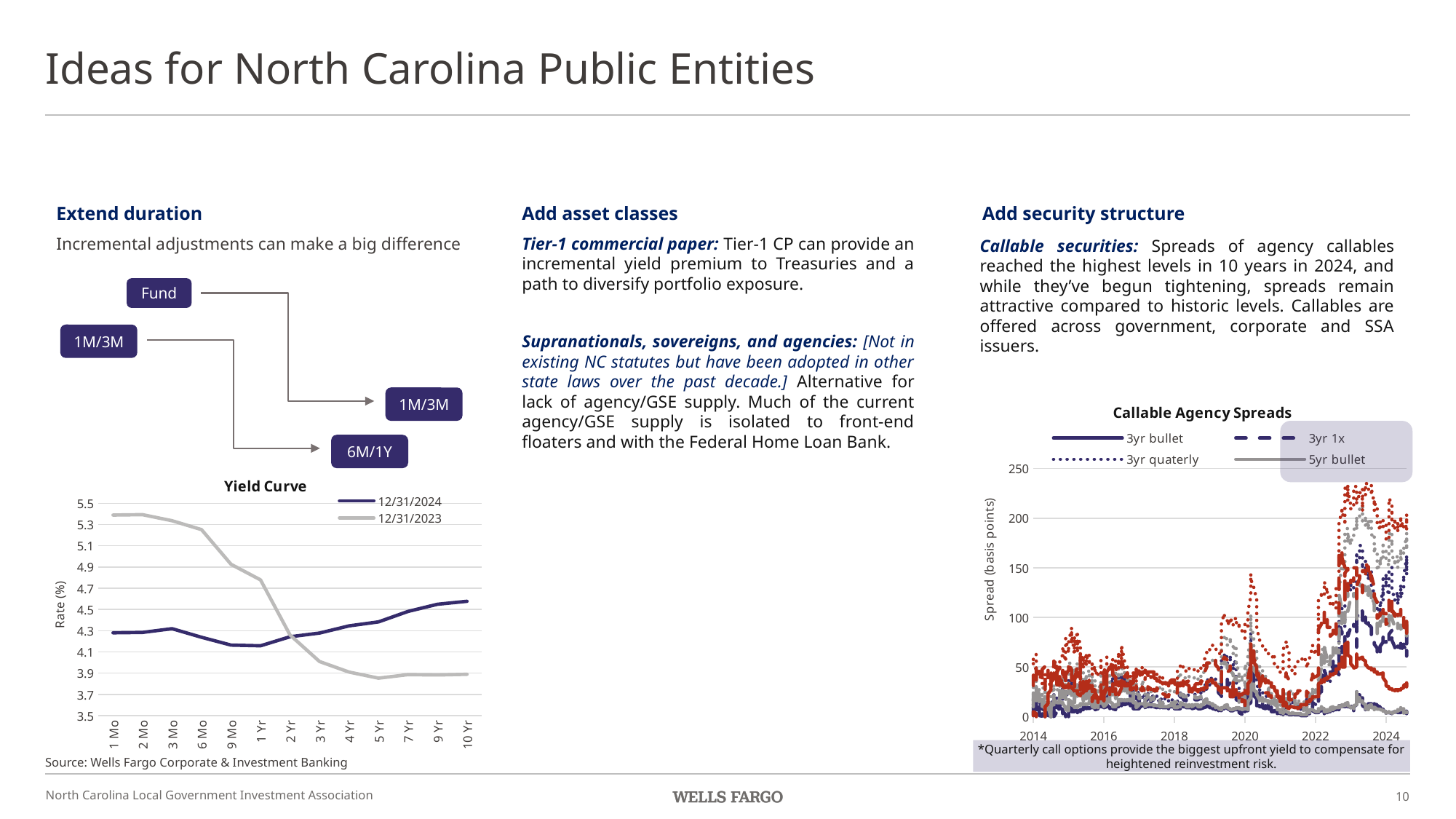
How many series does the legend of the Yield Curve chart list? 2 In the Yield Curve chart, which series has the higher rate at 10 Yr, 12/31/2024 or 12/31/2023? 12/31/2024 In the Callable Agency Spreads chart, is the peak value of the 3yr quaterly series greater or less than 200? less In the Yield Curve chart, is the 12/31/2024 rate at 1 Mo greater or less than 4.5? less How many series does the legend of the Callable Agency Spreads chart list? 4 What is the y-axis label of the Yield Curve chart? Rate (%) What type of chart is the Yield Curve chart? line chart In the Yield Curve chart, does the 12/31/2023 series rise or fall as maturity increases from 1 Mo to 10 Yr? fall How many maturity points are shown on the x axis of the Yield Curve chart? 13 In the Yield Curve chart, is the 12/31/2023 rate at 1 Mo greater or less than 5.1? greater In the Yield Curve chart, which series has the higher rate at 1 Mo, 12/31/2024 or 12/31/2023? 12/31/2023